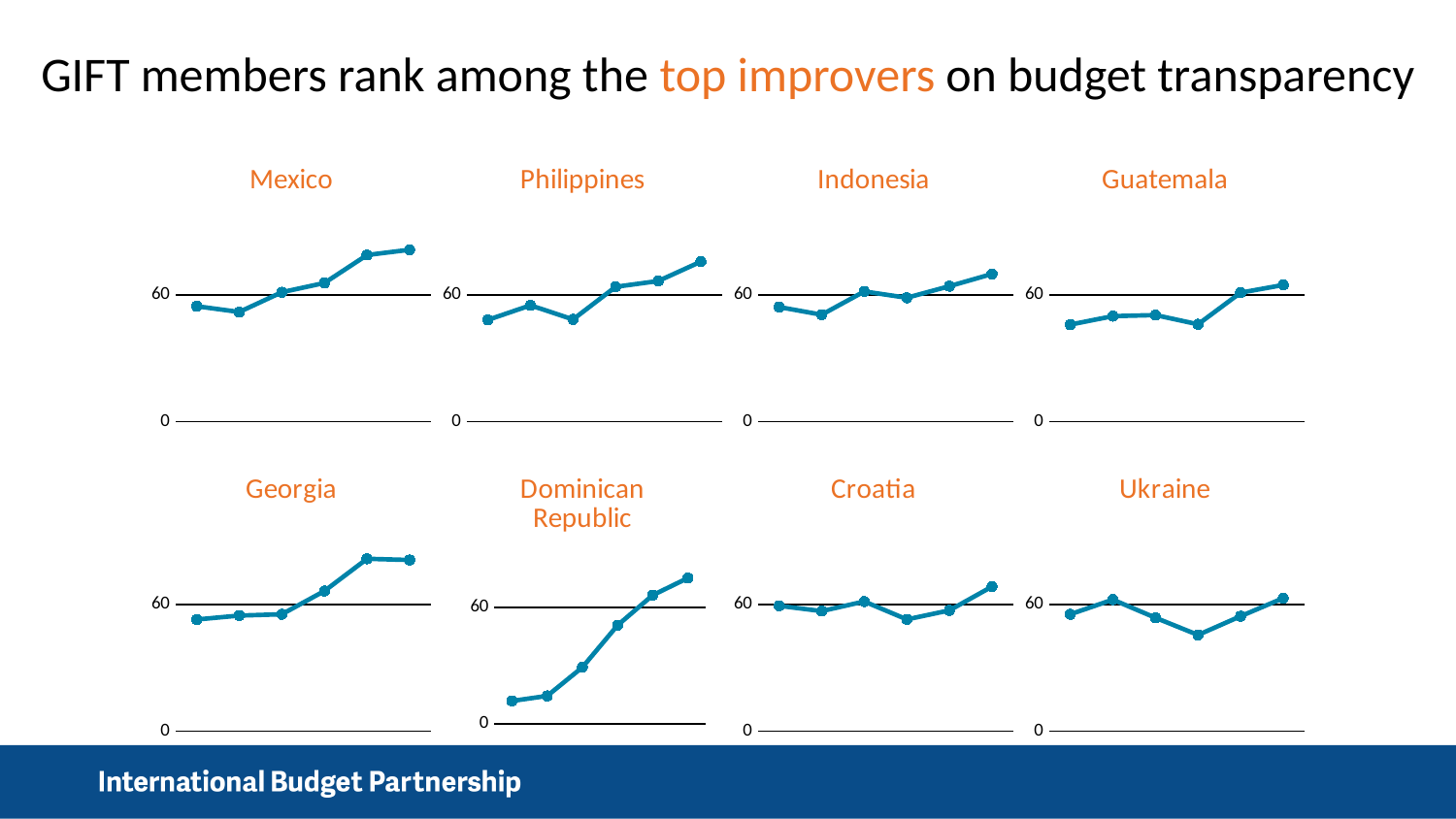
How many charts are shown on the slide? 8 In the Dominican Republic chart, do the values generally rise or fall from left to right? rise In the Mexico chart, do the values generally rise or fall from left to right? rise What kind of chart is used for Mexico? line chart In the Dominican Republic chart, is the first data point greater or less than 60? less In the Georgia chart, is the last data point greater or less than 60? greater In the Ukraine chart, is the fourth data point greater or less than 60? less In the Mexico chart, how many data points are plotted? 6 Which country's chart is shown in the top-left position? Mexico